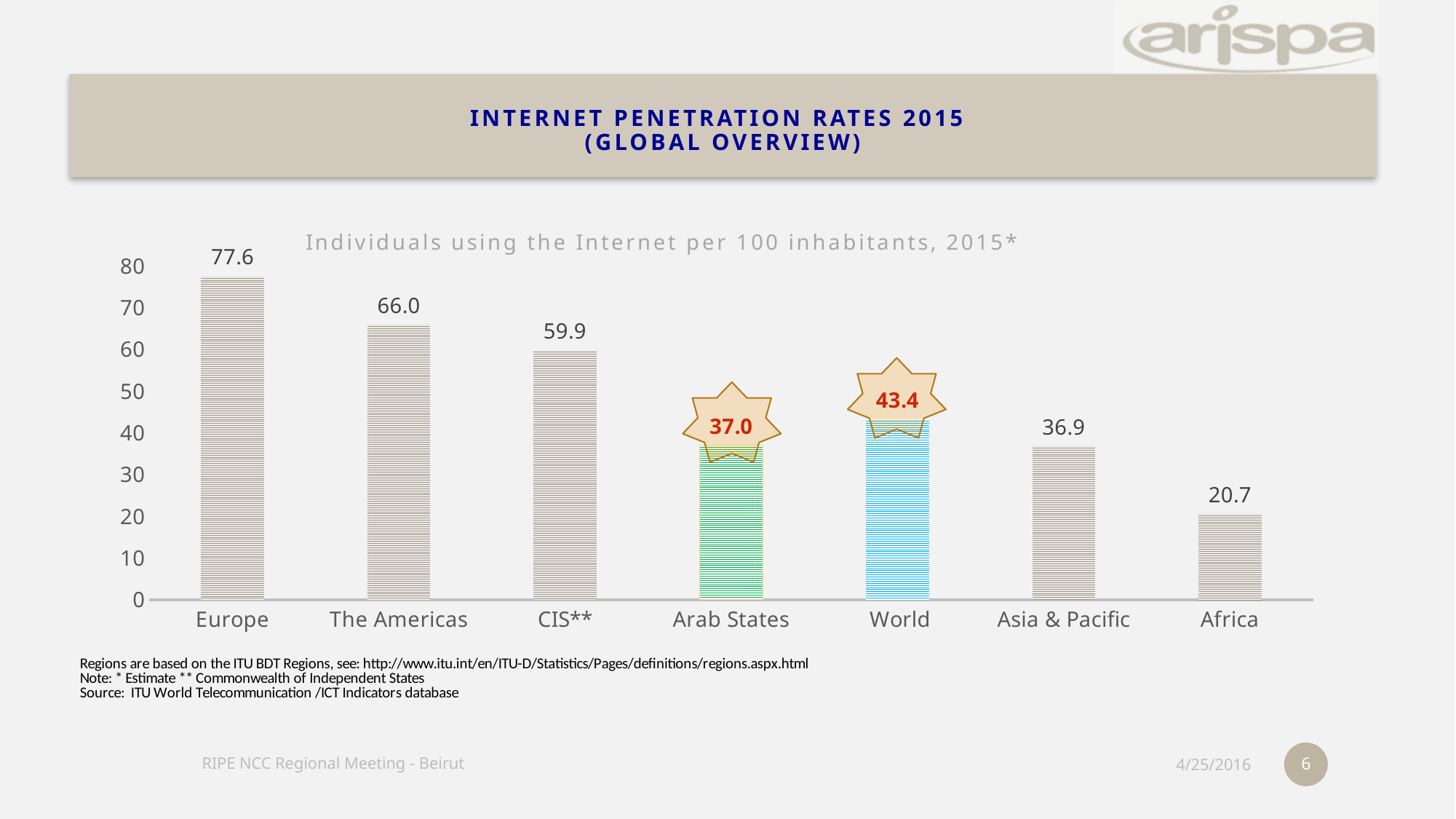
What is the value for Africa? 20.7 Which region has the lowest value? Africa Which is larger, the value for Arab States or the value for Asia & Pacific? Arab States What kind of chart is this? Bar chart What is the value for Arab States? 37.0 What is the difference between the values for Europe and The Americas? 11.6 What is the value for World? 43.4 What is the title of the chart? Individuals using the Internet per 100 inhabitants, 2015* What is the difference between the World value and the Arab States value? 6.4 Which region has the highest value? Europe What is the value for Europe? 77.6 How many regions are shown on the x axis? 7